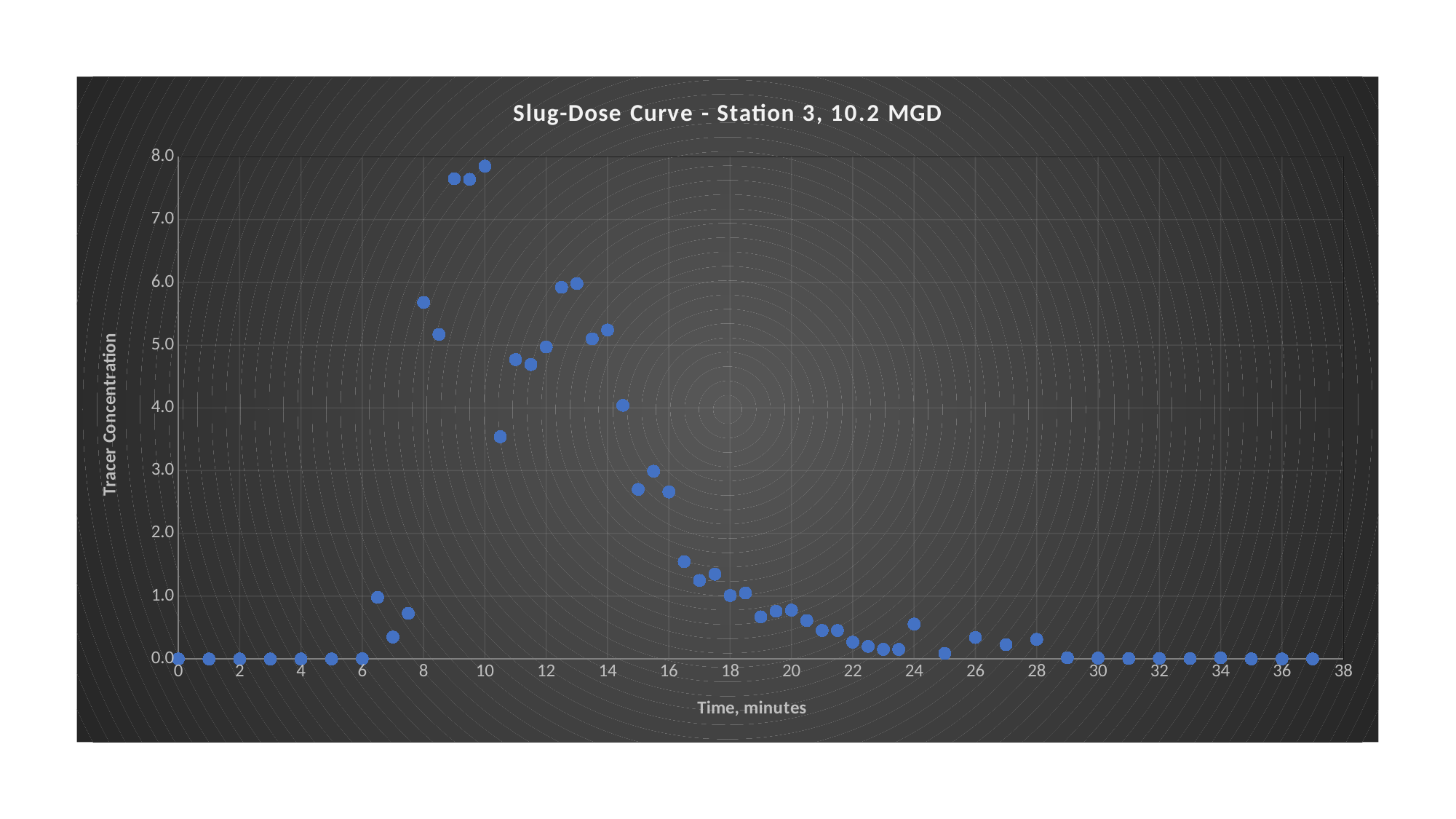
What is the tracer concentration at 0 minutes? 0.0 Is the tracer concentration at 10 minutes greater or less than 7.0? greater Is the tracer concentration at 15 minutes greater or less than 3.0? less What is the label of the x axis? Time, minutes Is the tracer concentration at 8 minutes greater or less than 5.0? greater Between 14 and 24 minutes, does the tracer concentration generally rise or fall? fall Which has the higher tracer concentration, 9 minutes or 11 minutes? 9 minutes At what time is the tracer concentration highest? 10 minutes What is the title of the chart? Slug-Dose Curve - Station 3, 10.2 MGD What kind of chart is shown on the slide? Scatter chart What is the tracer concentration at 36 minutes? 0.0